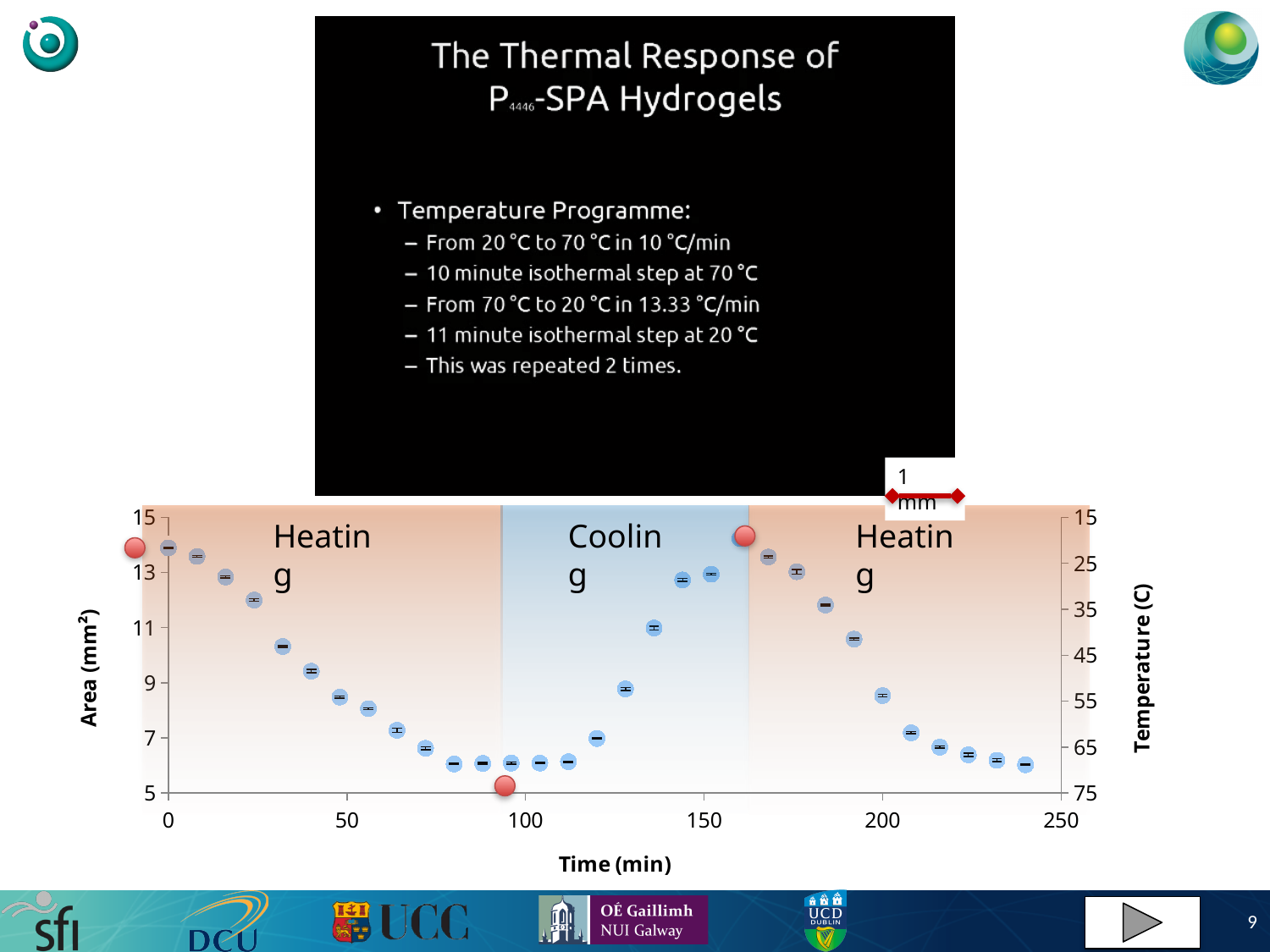
Is the area value at time 32 min greater or less than 9? greater Is the area value at time 136 min greater or less than 9? greater What is the title of the x axis of the chart? Time (min) What is the title of the left y axis of the chart? Area (mm²) Which is larger, the area at time 0 min or the area at time 80 min? time 0 min Does the area rise or fall as time increases from 0 to about 90 min (the first Heating region)? fall Does the area rise or fall as time increases through the Cooling region (about 95 to 155 min)? rise Which is larger, the area at time 200 min or the area at time 136 min? time 136 min What kind of chart is shown on the slide? scatter chart Is the area value at time 240 min greater or less than 7? less